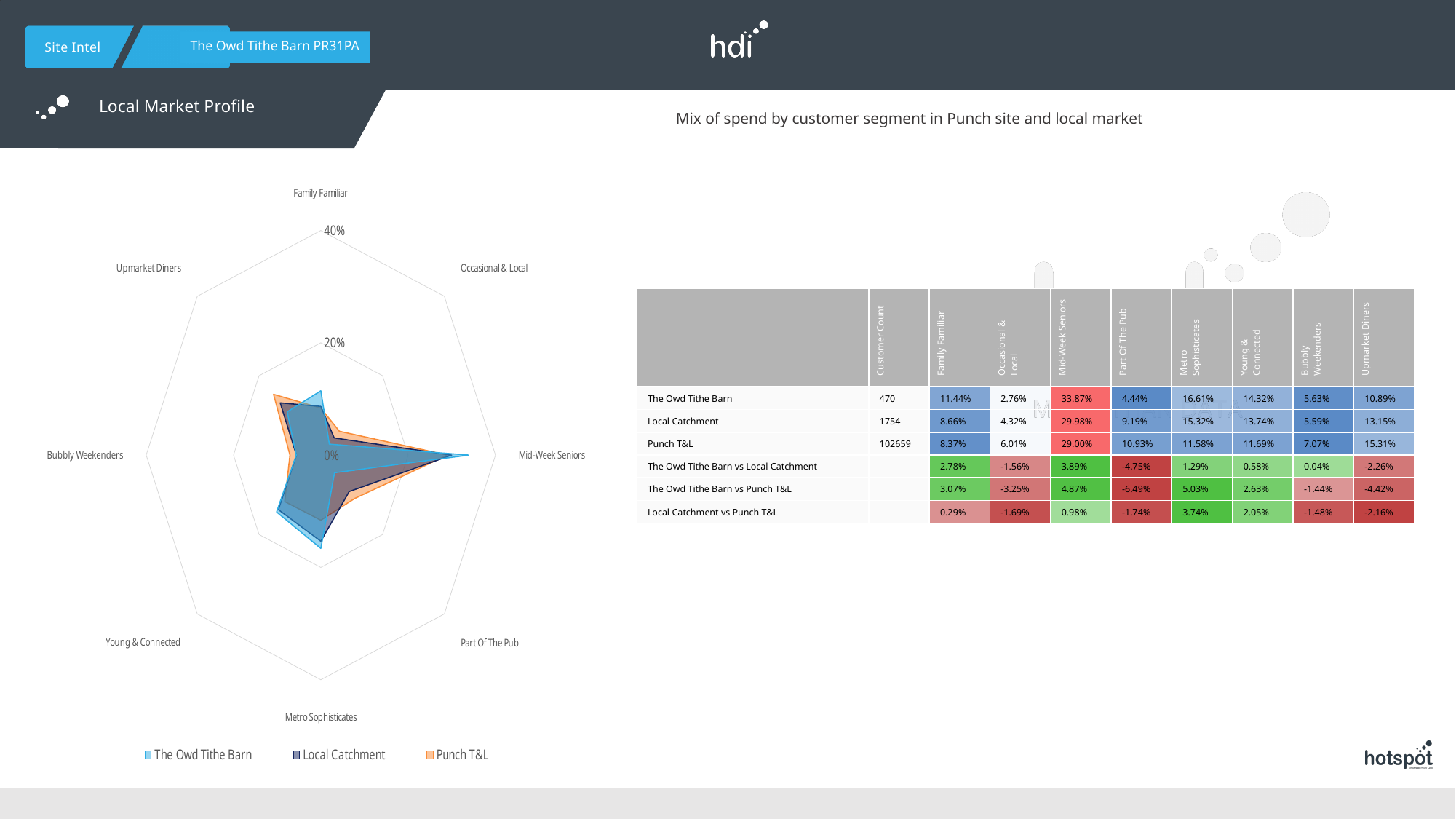
Which series in the radar chart legend is shown in orange? Punch T&L On the radar chart, is the Family Familiar value for The Owd Tithe Barn greater or less than 20%? less According to the table, what is the Upmarket Diners share for Punch T&L? 15.31% How many customer segment axes does the radar chart have? 8 Which customer segment has the lowest value for The Owd Tithe Barn on the radar chart? Occasional & Local What kind of chart is shown on the left of the slide? Radar chart On the radar chart, is the Mid-Week Seniors value for The Owd Tithe Barn greater or less than 20%? greater Which customer segment has the highest value for The Owd Tithe Barn on the radar chart? Mid-Week Seniors How many series does the legend of the radar chart list? 3 According to the table, what is the Mid-Week Seniors share for The Owd Tithe Barn? 33.87% What is the difference between The Owd Tithe Barn and Punch T&L for Mid-Week Seniors, as shown in the table? 4.87% For Mid-Week Seniors, which series is larger: The Owd Tithe Barn or Punch T&L? The Owd Tithe Barn